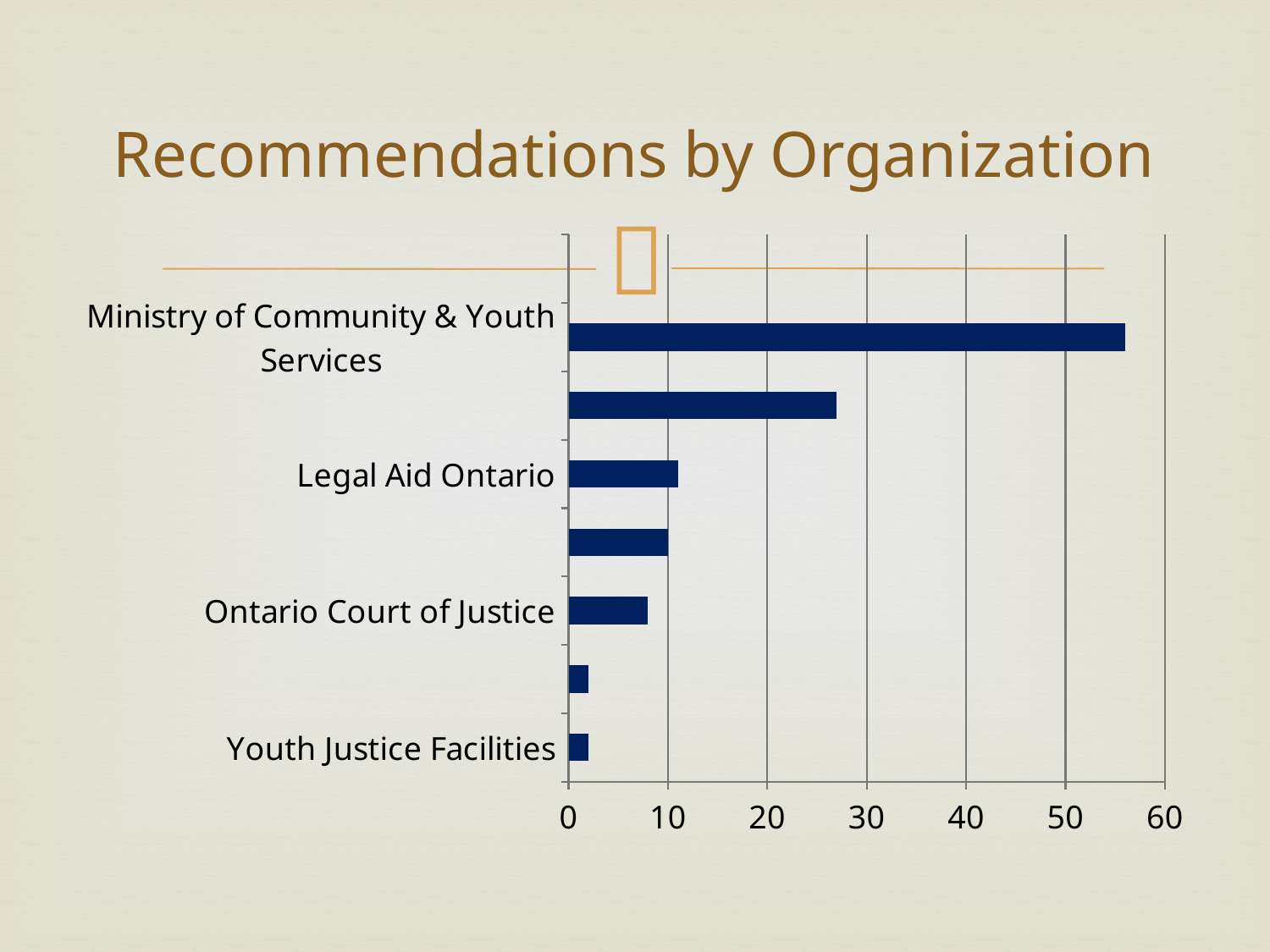
What kind of chart is shown on the slide? Bar chart Which organization has the highest number of recommendations? Ministry of Community & Youth Services What is the maximum value shown on the horizontal axis? 60 Which has more recommendations, Legal Aid Ontario or Ontario Court of Justice? Legal Aid Ontario Which has more recommendations, Ministry of Community & Youth Services or Legal Aid Ontario? Ministry of Community & Youth Services What is the title of the chart? Recommendations by Organization Is the value for Ontario Court of Justice greater or less than 10? less How many bars are plotted in the chart? 7 Is the value for Legal Aid Ontario greater or less than 20? less Which has more recommendations, Ontario Court of Justice or Youth Justice Facilities? Ontario Court of Justice Is the value for Youth Justice Facilities greater or less than 10? less